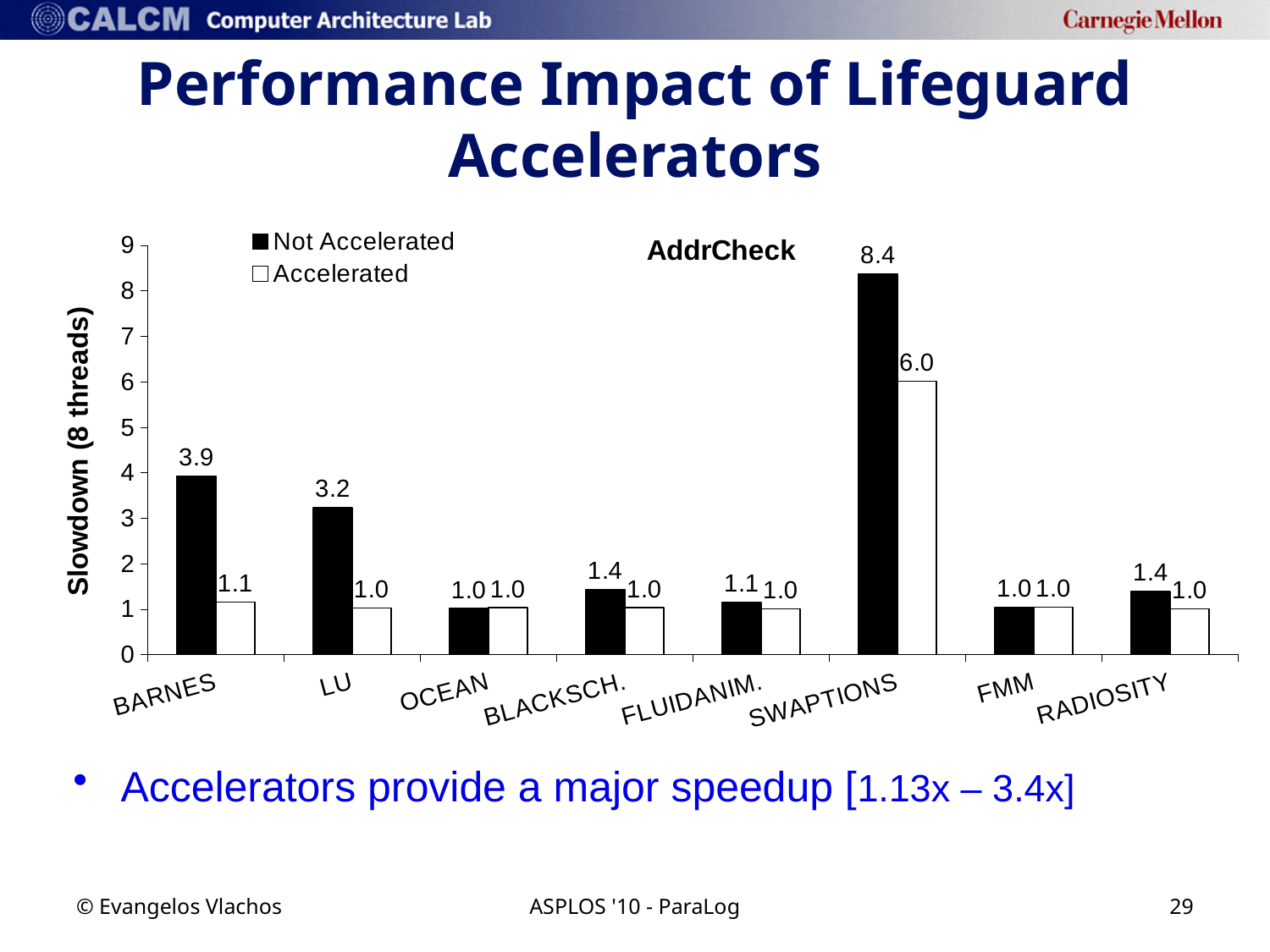
Which benchmark has the highest Not Accelerated slowdown? SWAPTIONS What is the difference between the Not Accelerated and Accelerated slowdown for SWAPTIONS? 2.4 Is the Not Accelerated slowdown for SWAPTIONS greater or less than 8? greater Which is larger, the Not Accelerated slowdown for BARNES or for LU? BARNES What is the Not Accelerated slowdown for LU? 3.2 How many series does the legend list? 2 What is the Accelerated slowdown for BARNES? 1.1 What is the label of the y axis? Slowdown (8 threads) What is the Not Accelerated slowdown for SWAPTIONS? 8.4 How many benchmarks are shown on the x axis? 8 What is the difference between the Not Accelerated and Accelerated slowdown for BARNES? 2.8 What kind of chart is shown? bar chart